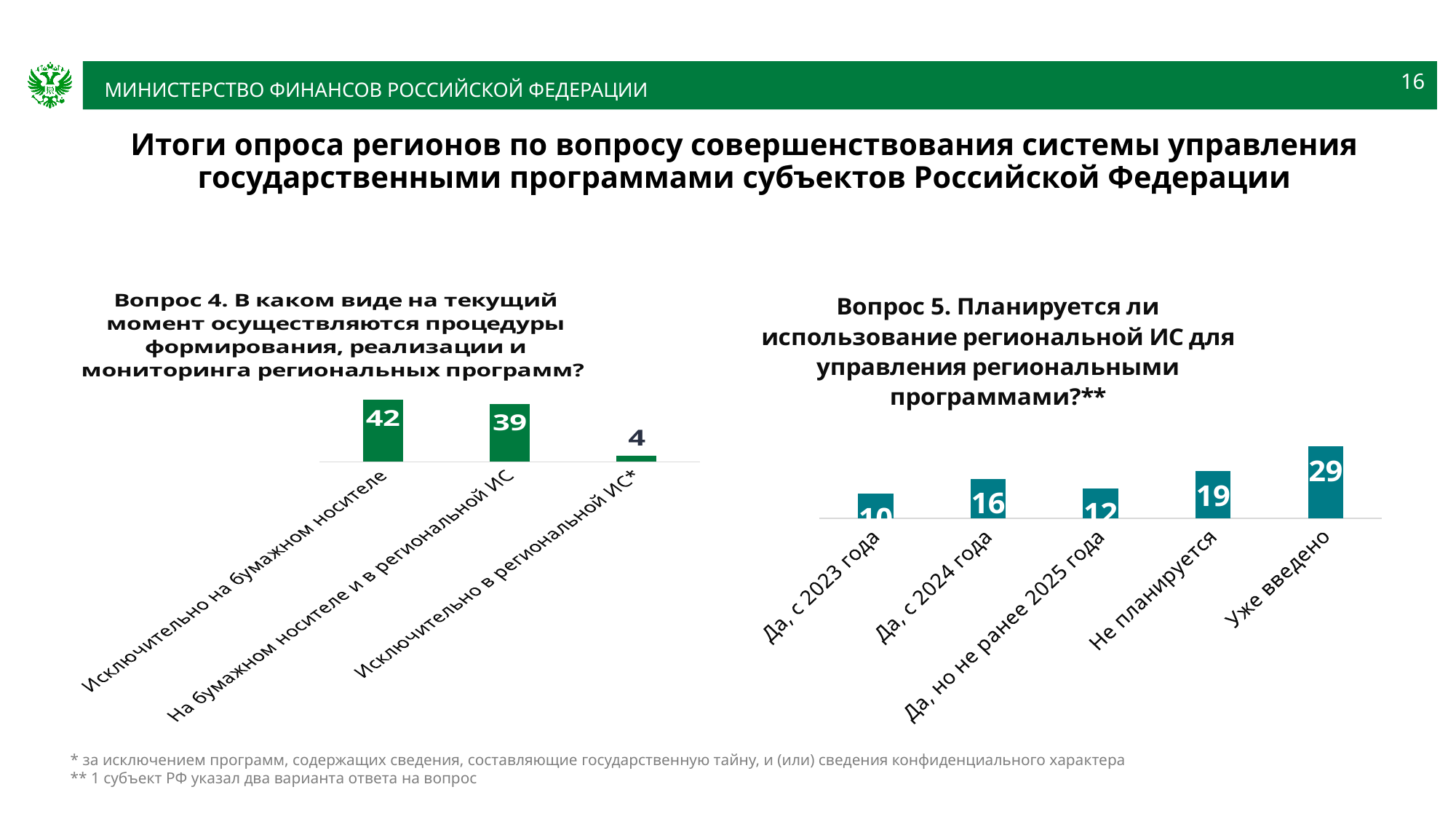
In the chart for Вопрос 5 (right), which category has the highest value? Уже введено In the chart for Вопрос 4 (left), which category has the lowest value? Исключительно в региональной ИС* What type of chart is used for Вопрос 5 (right)? Bar chart In the chart for Вопрос 5 (right), which is larger: 'Да, с 2024 года' or 'Да, но не ранее 2025 года'? Да, с 2024 года In the chart for Вопрос 4 (left), how many categories are shown? 3 In the chart for Вопрос 5 (right), what is the difference between 'Уже введено' and 'Да, с 2023 года'? 19 In the chart for Вопрос 4 (left), what is the value for 'На бумажном носителе и в региональной ИС'? 39 In the chart for Вопрос 5 (right), which category has the lowest value? Да, с 2023 года In the chart for Вопрос 4 (left), what is the value for 'Исключительно на бумажном носителе'? 42 In the chart for Вопрос 4 (left), what is the difference between 'Исключительно на бумажном носителе' and 'Исключительно в региональной ИС*'? 38 In the chart for Вопрос 5 (right), what is the value for 'Не планируется'? 19 In the chart for Вопрос 5 (right), what is the value for 'Уже введено'? 29